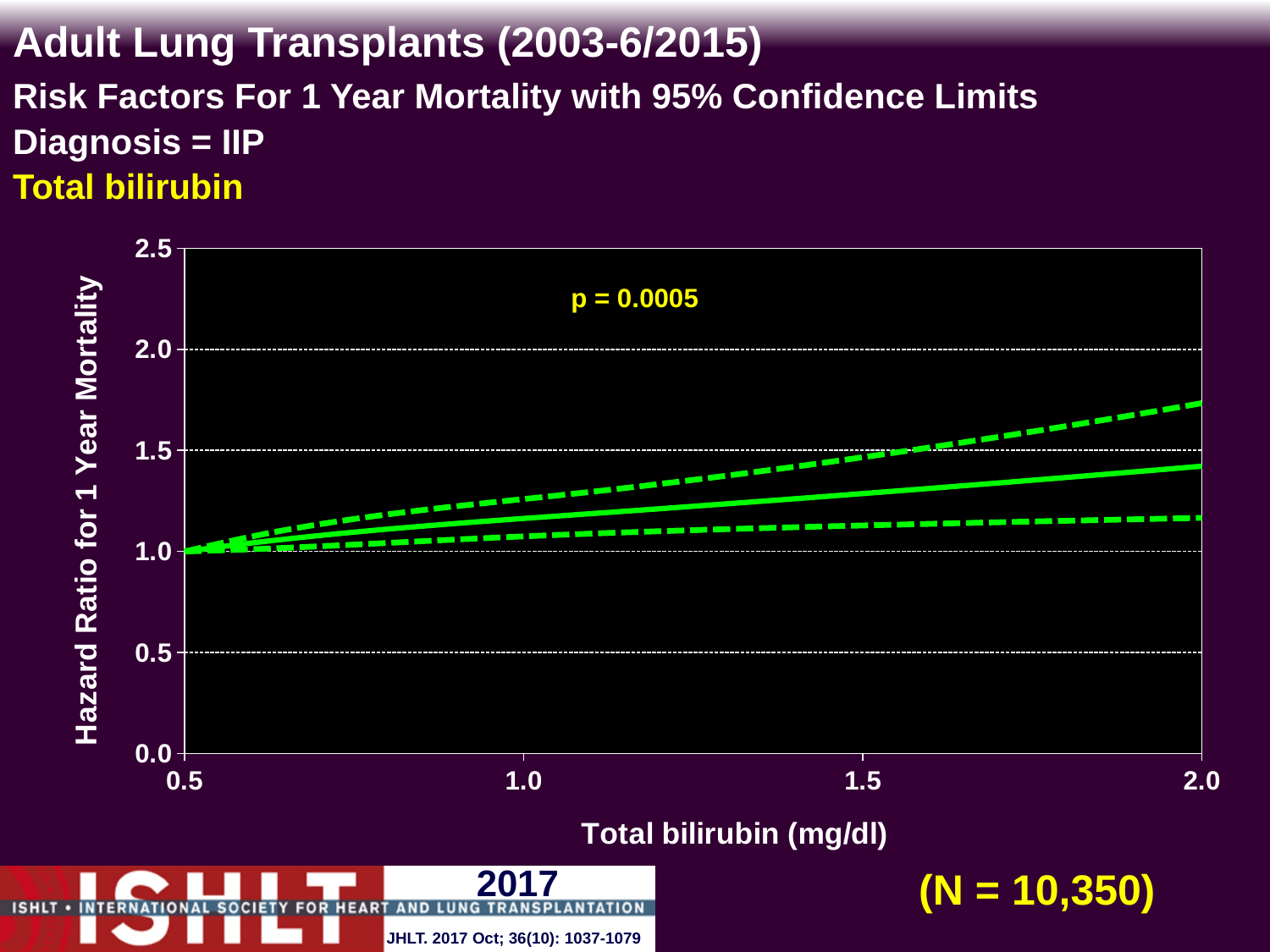
At a total bilirubin of 0.5 mg/dl, is the hazard ratio greater or less than 1.5? less What kind of chart is shown on the slide? line chart Is the hazard ratio (solid line) at a total bilirubin of 1.0 mg/dl greater or less than 1.5? less Is the hazard ratio (solid line) at a total bilirubin of 2.0 mg/dl greater or less than 1.5? less Does the hazard ratio for 1 year mortality rise or fall as total bilirubin increases from 0.5 to 2.0 mg/dl? rise What is the sample size (N) shown on the slide? 10,350 What is the label of the y axis? Hazard Ratio for 1 Year Mortality What is the label of the x axis? Total bilirubin (mg/dl) What p-value is printed on the chart? p = 0.0005 How many lines are plotted on the chart? 3